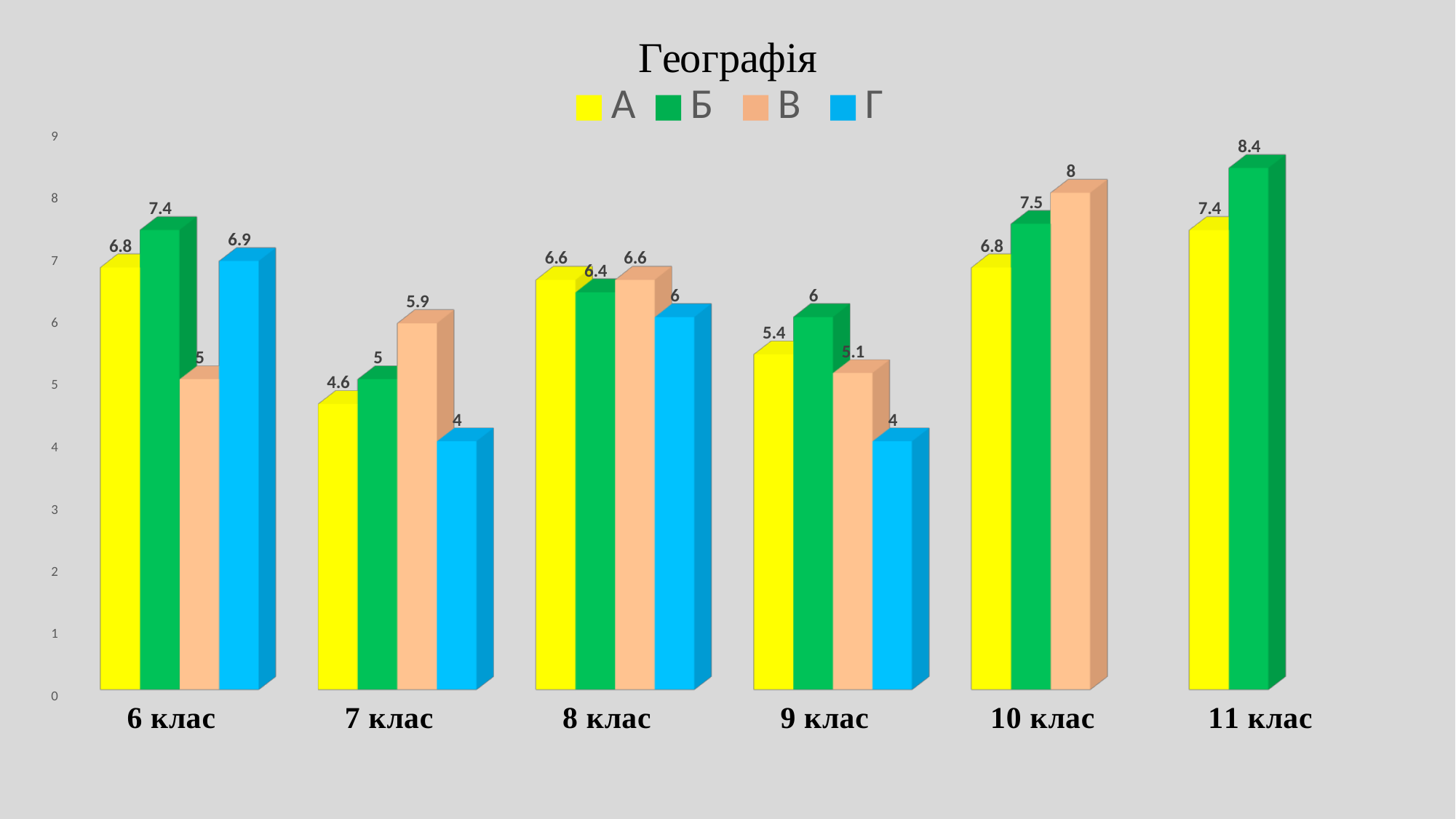
What kind of chart is shown? bar chart What is the value for series В in 10 клас? 8 Which is larger in 8 клас: series А or series Б? А Which series has the lowest value in 9 клас? Г What colour represents series Г in the legend? blue What is the value for series Г in 7 клас? 4 What is the title of the chart? Географія What is the value for series Б in 6 клас? 7.4 How many series does the legend list? 4 How many class categories are shown on the x axis? 6 What is the difference between series Б and series А in 11 клас? 1 Which series has the highest value in 11 клас? Б